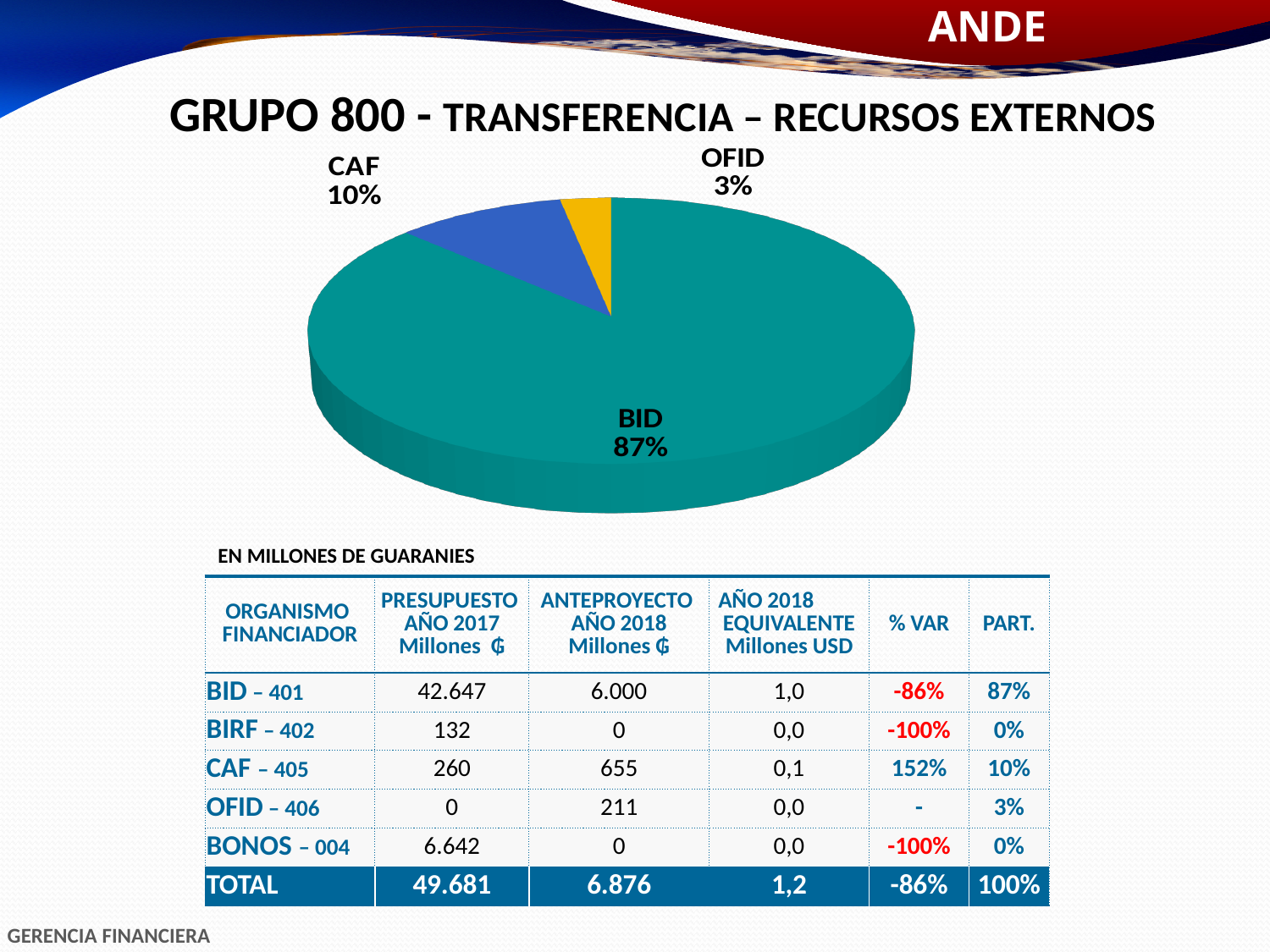
What share of the pie does OFID hold? 3% Which slice of the pie chart is the largest? BID What is the title of the chart on the slide? GRUPO 800 - TRANSFERENCIA – RECURSOS EXTERNOS What is the difference in percentage points between the BID slice and the CAF slice? 77 What colour is the BID slice of the pie chart? teal What kind of chart is shown on the slide? pie chart Which slice of the pie chart is the smallest? OFID Which slice is larger, CAF or OFID? CAF How many slices are labelled in the pie chart? 3 What is the difference in percentage points between the CAF slice and the OFID slice? 7 What share of the pie does CAF hold? 10% What share of the pie does BID hold? 87%